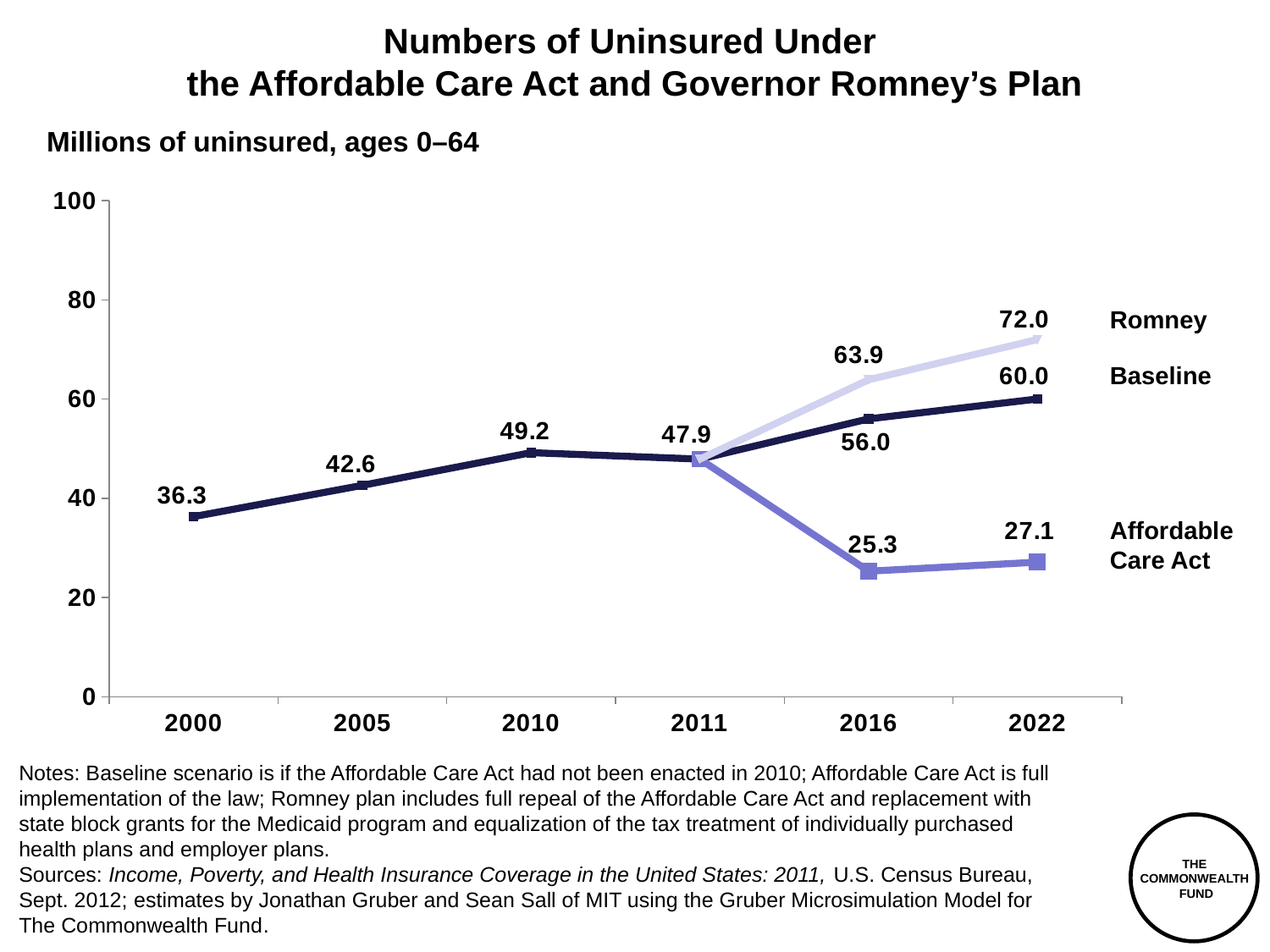
Which scenario has the lowest projected number of uninsured in 2022? Affordable Care Act Does the Affordable Care Act line rise or fall between 2011 and 2016? Fall What is the projected number of uninsured under the Affordable Care Act in 2016? 25.3 What kind of chart is shown on the slide? Line chart What is the Baseline value of uninsured in 2000? 36.3 What is the difference between the Romney and Affordable Care Act values in 2022? 44.9 What is the Baseline value in 2016? 56.0 Which is larger in 2016, the Romney value or the Baseline value? Romney How many years are labeled on the x axis? 6 What is the difference between the Baseline values in 2010 and 2000? 12.9 What is the projected number of uninsured under the Romney plan in 2022? 72.0 Which scenario has the highest projected number of uninsured in 2022? Romney